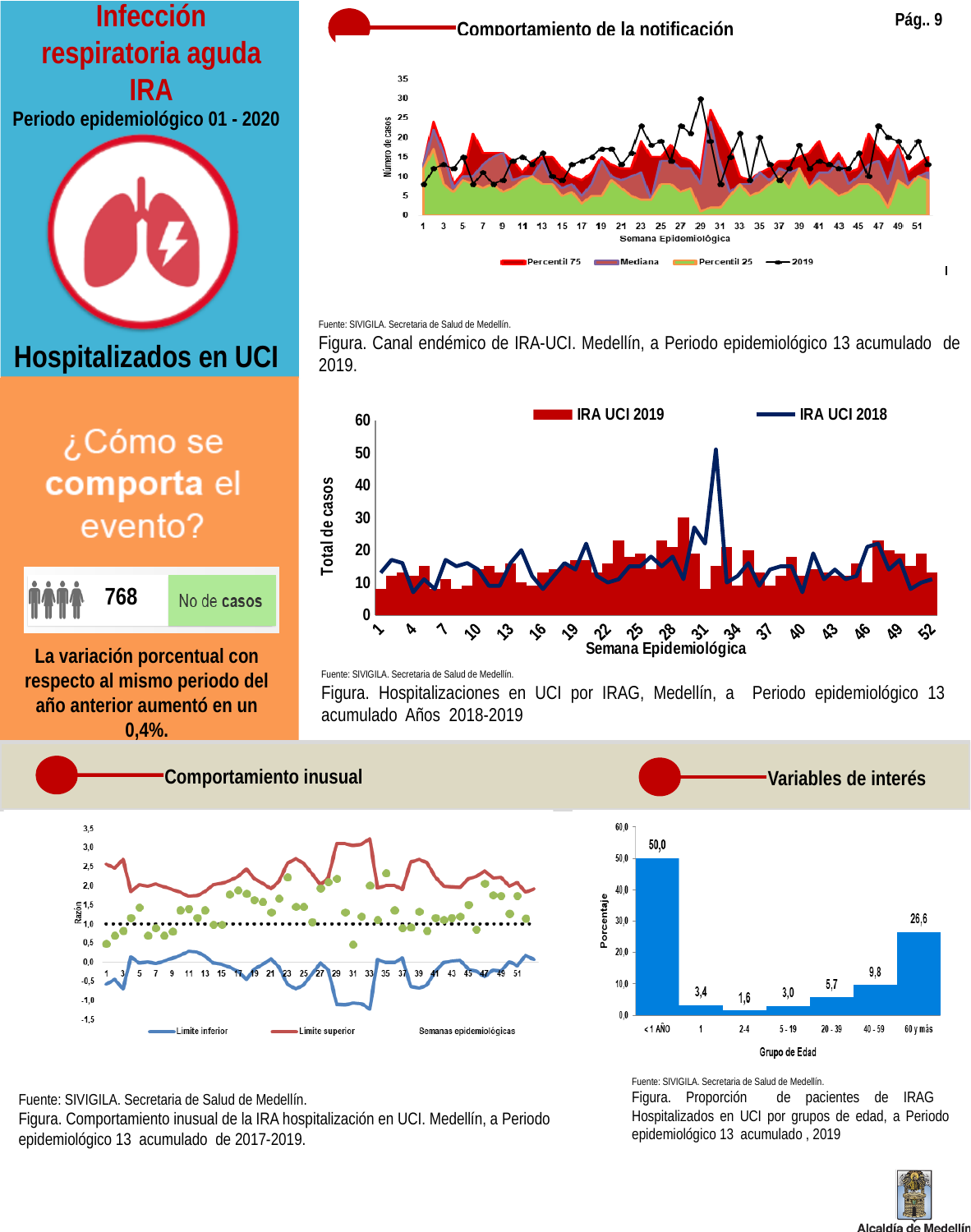
In the bottom-right chart by age group, what is the value for the '60 y más' group? 26,6 In the bottom-right chart by age group, which age group has the highest percentage? < 1 AÑO In the bottom-right chart by age group, what is the difference between the '< 1 AÑO' value and the '60 y más' value? 23,4 In the middle-right chart of hospitalizations in UCI by IRAG, is the peak value of the IRA UCI 2018 line greater or less than 40? greater How many age groups are shown in the bottom-right chart by age group? 7 How many series does the legend list in the middle-right chart of hospitalizations in UCI by IRAG (2018-2019)? 2 In the bottom-right chart by age group, which age group has the lowest percentage? 2-4 In the bottom-right chart by age group, what is the value for the '40 - 59' group? 9,8 What kind of chart is the bottom-right chart of IRAG patients by age group? Bar chart In the bottom-right chart by age group, which is larger: the value for '20 - 39' or the value for '5 - 19'? 20 - 39 In the bottom-right chart of IRAG patients hospitalized in UCI by age group, what is the value for the '< 1 AÑO' group? 50,0 How many series does the legend list in the top-right endemic channel chart (Canal endémico de IRA-UCI)? 4